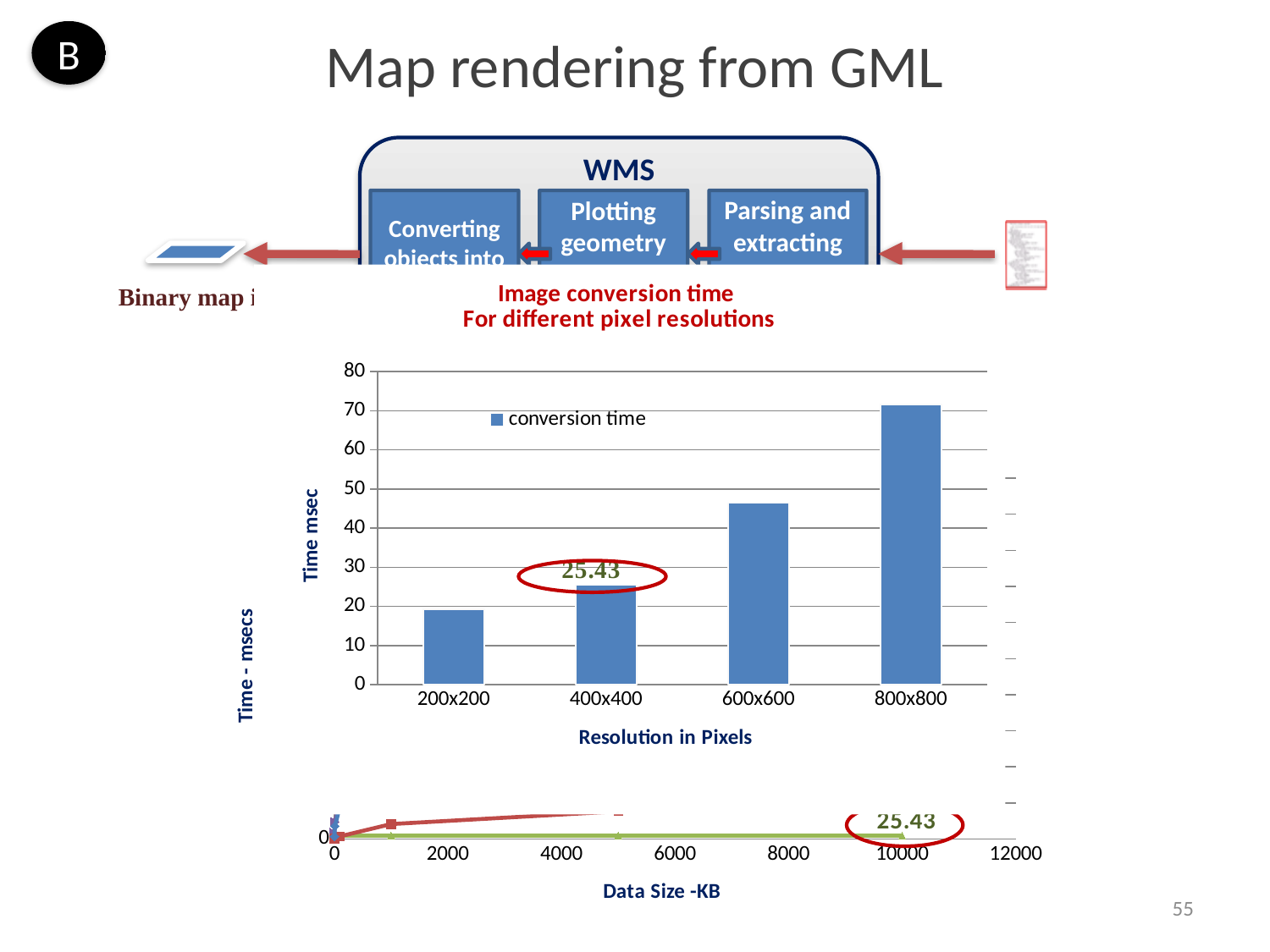
How many series does the legend of the bar chart 'Image conversion time For different pixel resolutions' list? 1 What is the x-axis title of the bar chart 'Image conversion time For different pixel resolutions'? Resolution in Pixels In the bar chart 'Image conversion time For different pixel resolutions', which has a larger conversion time, 600x600 or 400x400? 600x600 In the bar chart 'Image conversion time For different pixel resolutions', is the value for 800x800 greater or less than 60? greater What kind of chart is the 'Image conversion time For different pixel resolutions' chart? bar chart In the bar chart 'Image conversion time For different pixel resolutions', what is the conversion time for the 400x400 resolution? 25.43 In the bar chart 'Image conversion time For different pixel resolutions', which resolution has the highest conversion time? 800x800 In the bar chart 'Image conversion time For different pixel resolutions', is the value for 200x200 greater or less than 30? less In the bar chart 'Image conversion time For different pixel resolutions', do the conversion times rise or fall as the resolution increases from 200x200 to 800x800? rise In the bar chart 'Image conversion time For different pixel resolutions', is the value for 600x600 greater or less than 40? greater In the bar chart 'Image conversion time For different pixel resolutions', which resolution has the lowest conversion time? 200x200 How many resolution categories are shown in the bar chart 'Image conversion time For different pixel resolutions'? 4